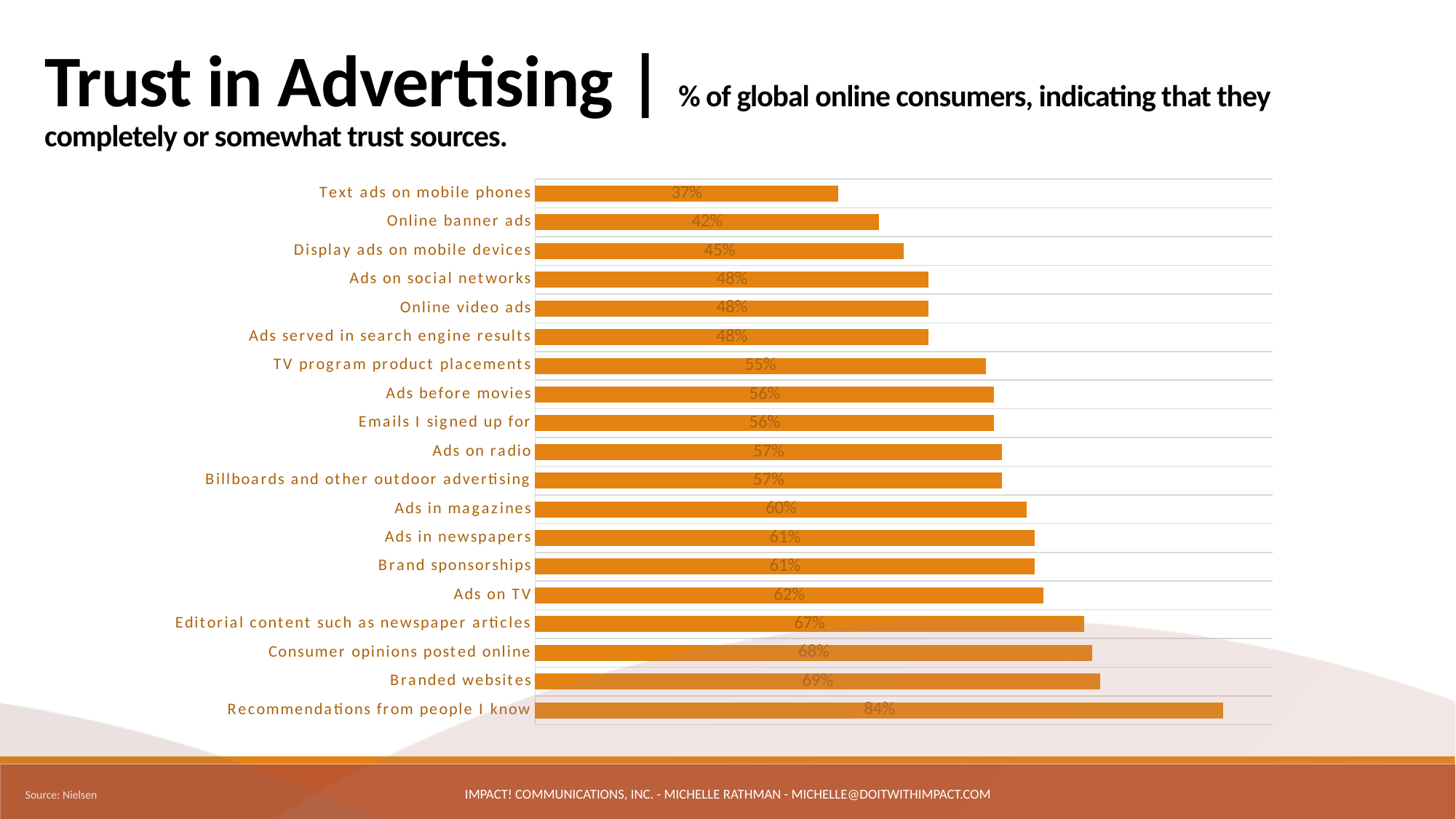
What is the value for Recommendations from people I know? 84% Which category has the lowest value? Text ads on mobile phones Which is larger, Editorial content such as newspaper articles or Ads on radio? Editorial content such as newspaper articles What source is cited for the chart? Nielsen What is the difference between Recommendations from people I know and Branded websites? 15% What is the value for Text ads on mobile phones? 37% What is the value for Ads on TV? 62% Which category has the highest value? Recommendations from people I know What is the value for Consumer opinions posted online? 68% What is the difference between Ads in magazines and Online banner ads? 18% How many categories are shown in the chart? 19 What kind of chart is shown on the slide? Bar chart